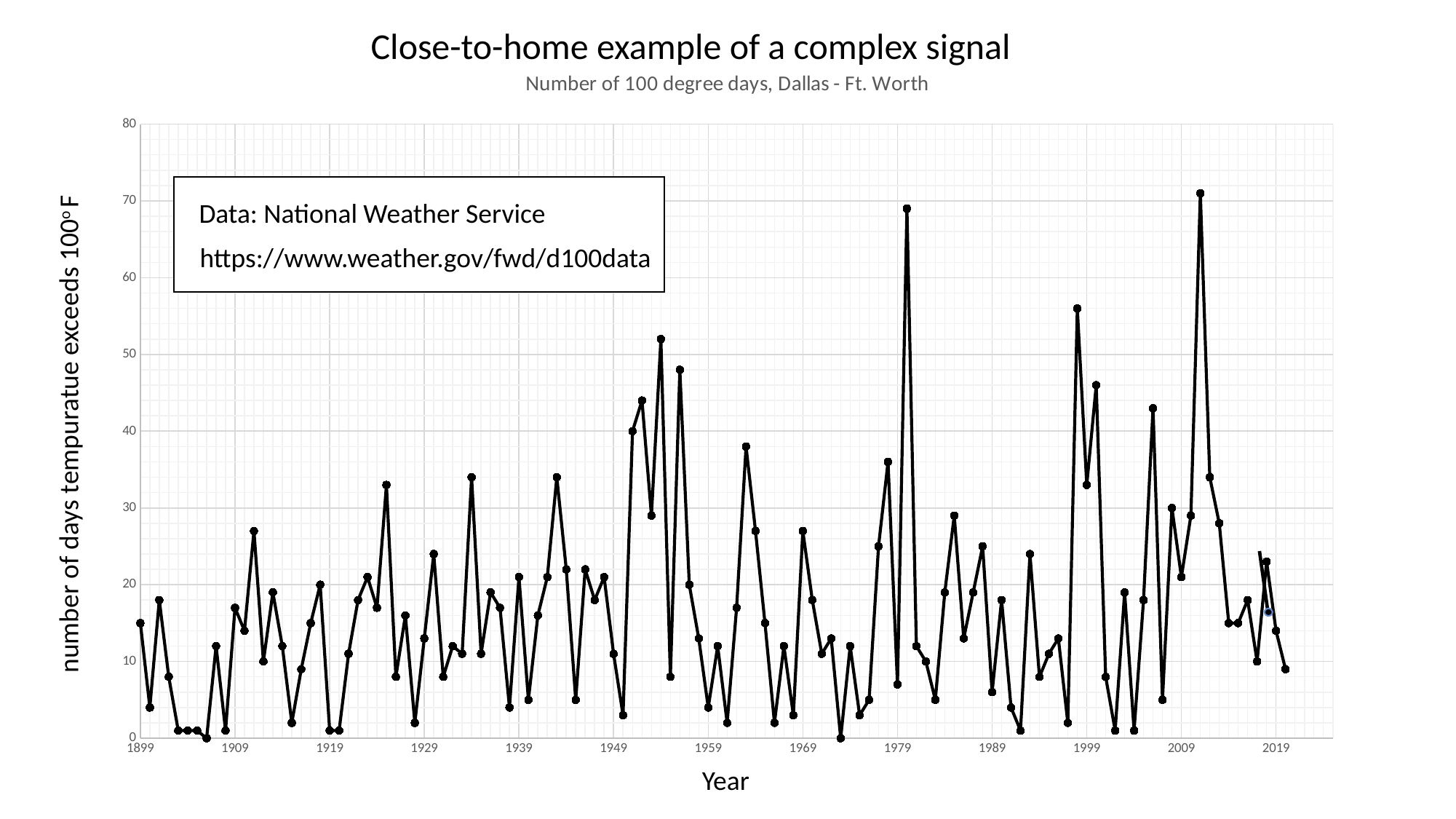
Which year has the larger value, 1899 or 1909? 1909 Does the value rise or fall from 1899 to 1909? rise Is the value for 1999 greater or less than 30? greater Is the value for 2019 greater or less than 10? greater Which year has the larger value, 1999 or 2019? 1999 What is the label on the x axis of the chart? Year Is the highest value on the chart greater or less than 60? greater What is the title of the chart? Number of 100 degree days, Dallas - Ft. Worth What kind of chart is shown on the slide? line chart